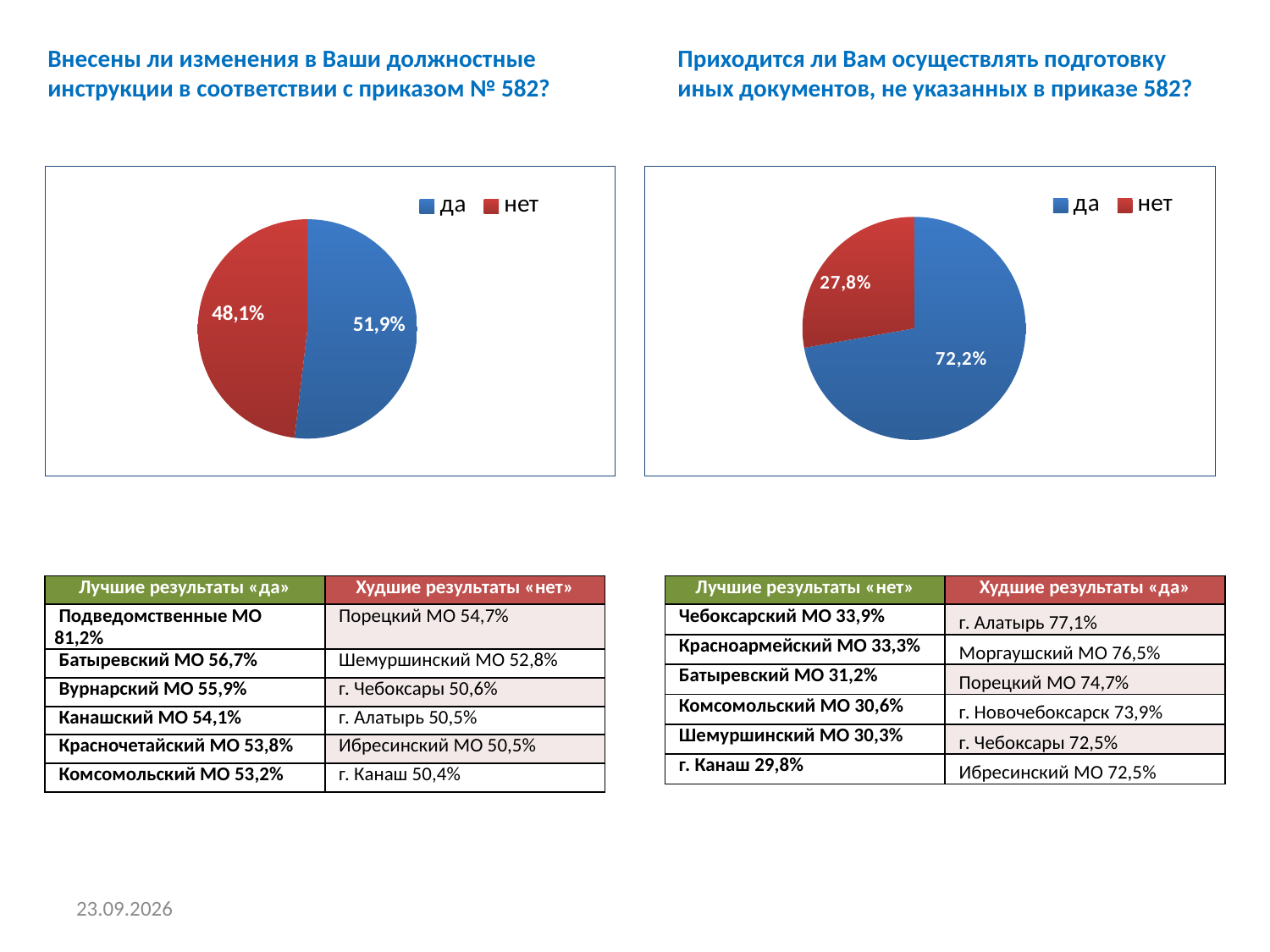
In the left pie chart, what is the difference between the "да" and "нет" slices? 3,8% In the right pie chart, what is the value for "да"? 72,2% In the right pie chart, which slice is the smallest? нет In the right pie chart, which slice is the largest? да In the right pie chart, what is the value for "нет"? 27,8% In the left pie chart, what is the value for "да"? 51,9% In the left pie chart, what colour is the "нет" slice? red What type of chart is the left chart? pie chart In the left pie chart, what is the value for "нет"? 48,1% How many entries does the legend of the right chart list? 2 In the right pie chart, what is the difference between the "да" and "нет" slices? 44,4% In the left pie chart, which is larger, "да" or "нет"? да